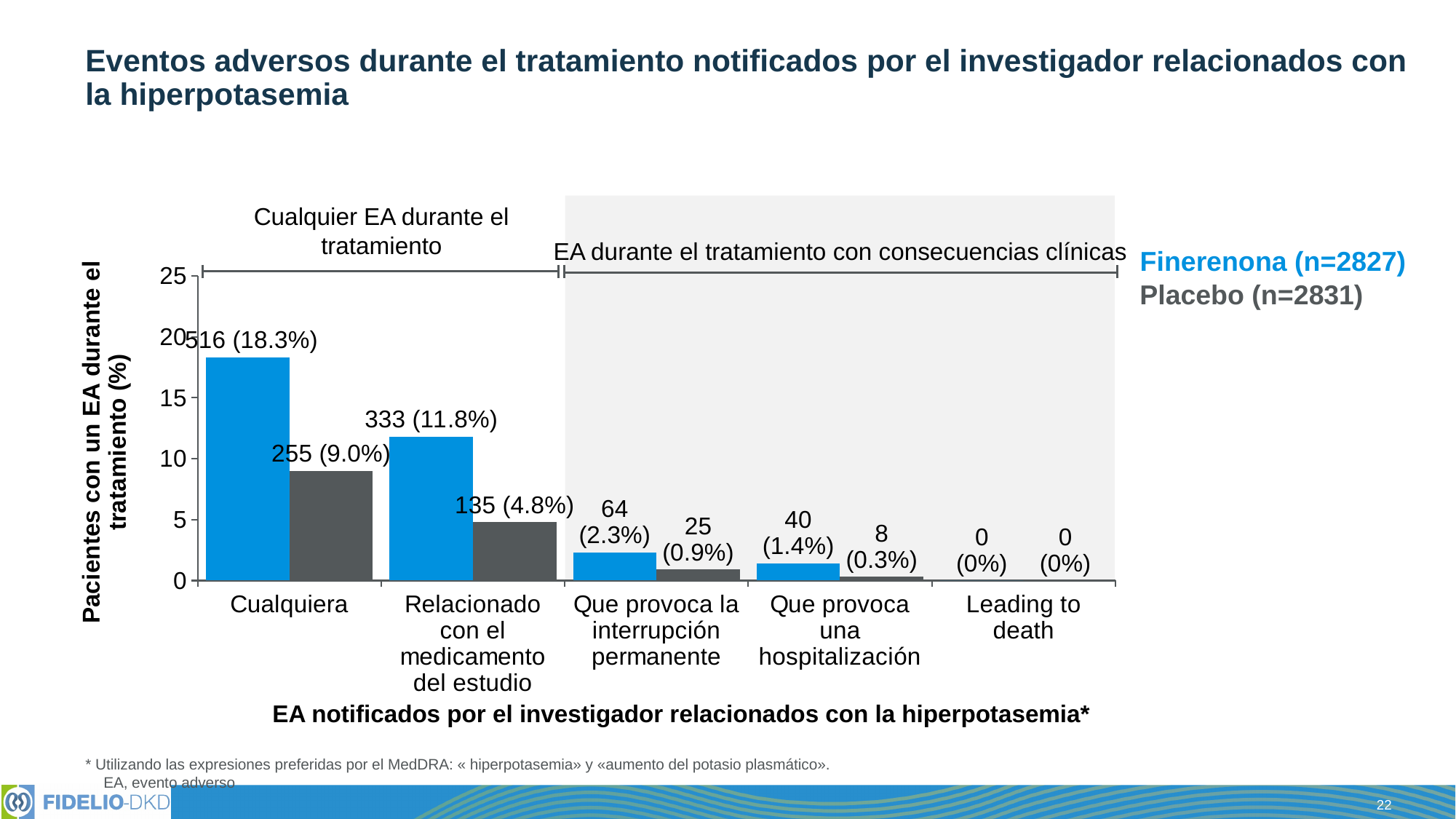
What is the difference in percentage points between Finerenona and Placebo in the 'Cualquiera' category? 9.3 What is the data label for Finerenona in the 'Relacionado con el medicamento del estudio' category? 333 (11.8%) How many series does the legend list? 2 Which category has the lowest value for Placebo? Leading to death What is the data label for Placebo in the 'Que provoca la interrupción permanente' category? 25 (0.9%) What is the data label for Finerenona in the 'Que provoca una hospitalización' category? 40 (1.4%) What is the data label for Placebo in the 'Cualquiera' category? 255 (9.0%) Which category has the highest value for Finerenona? Cualquiera What type of chart is shown on the slide? Bar chart How many categories are shown on the x axis? 5 Which is larger in the 'Relacionado con el medicamento del estudio' category, Finerenona or Placebo? Finerenona What is the data label for Finerenona in the 'Cualquiera' category? 516 (18.3%)